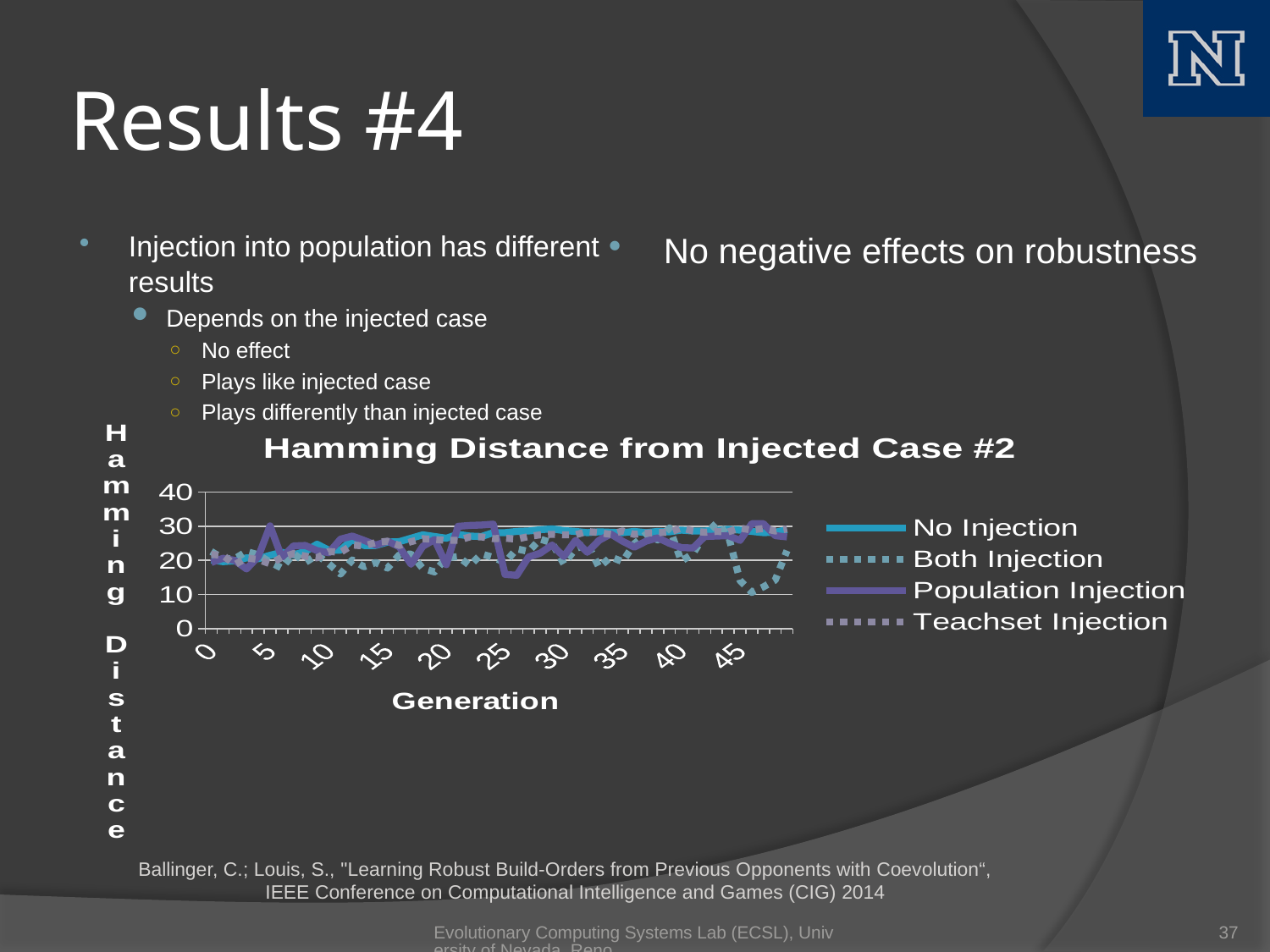
What is the highest value shown on the y axis of the chart? 40 What is the title of the chart? Hamming Distance from Injected Case #2 Is the value for Population Injection at generation 0 greater or less than 30? less Is the value for No Injection at generation 0 greater or less than 10? greater Is the value for No Injection at generation 40 greater or less than 20? greater What kind of chart is shown on the slide? line chart Does the No Injection series generally rise or fall as the generation increases? rise What label is shown on the x axis of the chart? Generation How many series does the chart's legend list? 4